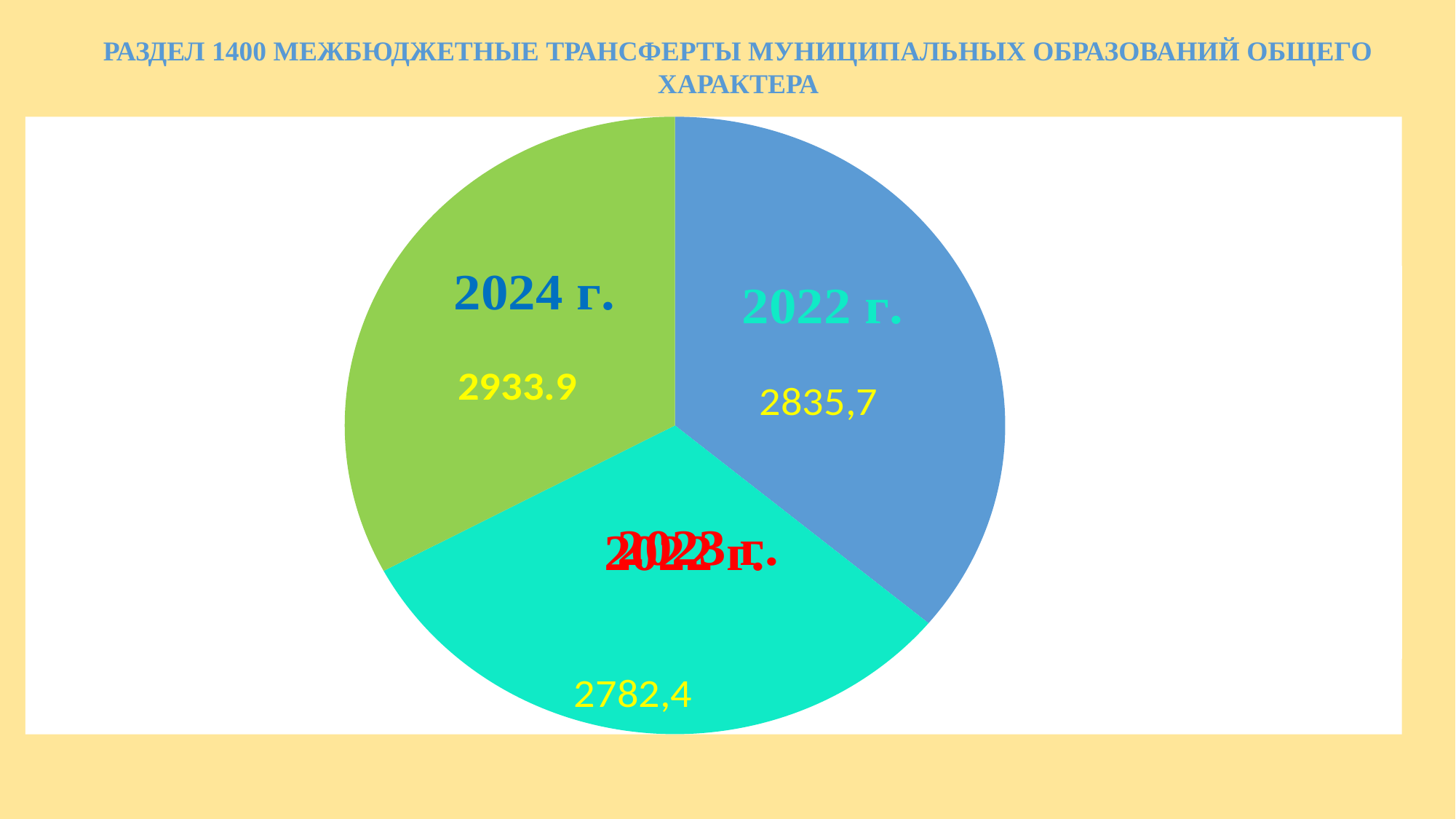
What is the value shown on the cyan slice at the bottom of the pie? 2782,4 What is the difference between the 2024 г. value and the 2022 г. value? 98,2 Which slice has the smallest value? the cyan (bottom) slice, 2782,4 What is the value shown for the 2024 г. slice? 2933.9 What is the title of the slide above the chart? РАЗДЕЛ 1400 МЕЖБЮДЖЕТНЫЕ ТРАНСФЕРТЫ МУНИЦИПАЛЬНЫХ ОБРАЗОВАНИЙ ОБЩЕГО ХАРАКТЕРА What is the difference between the 2022 г. value and the value of the cyan bottom slice? 53,3 What kind of chart is shown on the slide? pie chart How many slices does the pie chart have? 3 What is the value shown for the 2022 г. slice (the blue slice)? 2835,7 What colour is the 2024 г. slice? green